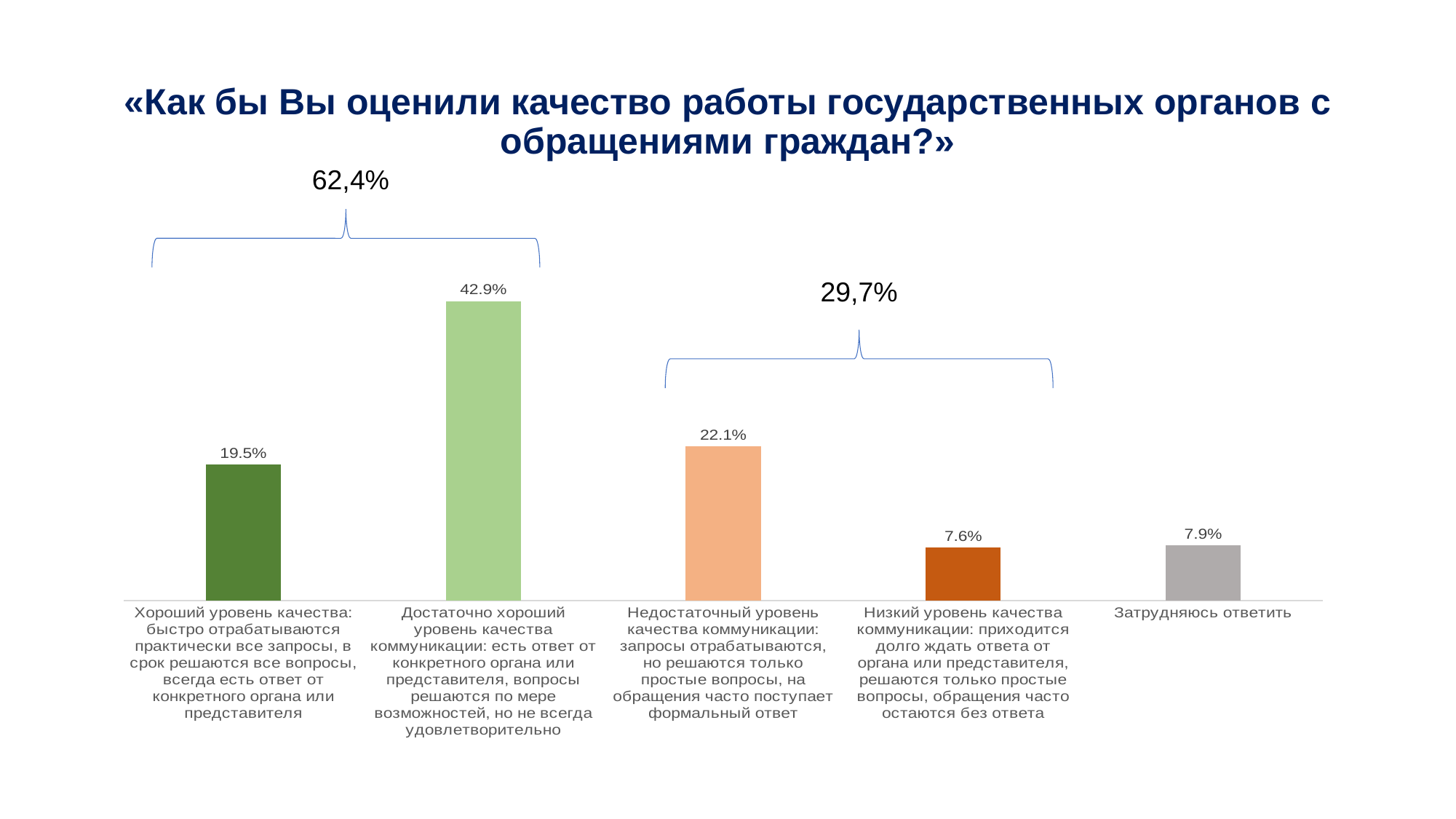
What combined percentage is shown by the bracket above the two green bars? 62,4% Which is larger: the value for "Недостаточный уровень качества коммуникации" or the value for "Хороший уровень качества"? Недостаточный уровень качества коммуникации Which category has the highest value? Достаточно хороший уровень качества коммуникации What is the value for the category "Затрудняюсь ответить"? 7.9% What is the value for the category "Недостаточный уровень качества коммуникации"? 22.1% What is the difference between the values for "Достаточно хороший уровень качества коммуникации" and "Хороший уровень качества"? 23.4% What is the value for the category "Достаточно хороший уровень качества коммуникации"? 42.9% What is the value for the category "Хороший уровень качества"? 19.5% What is the value for the category "Низкий уровень качества коммуникации"? 7.6% How many categories (bars) does the chart show? 5 Which category has the lowest value? Низкий уровень качества коммуникации What type of chart is shown on the slide? bar chart